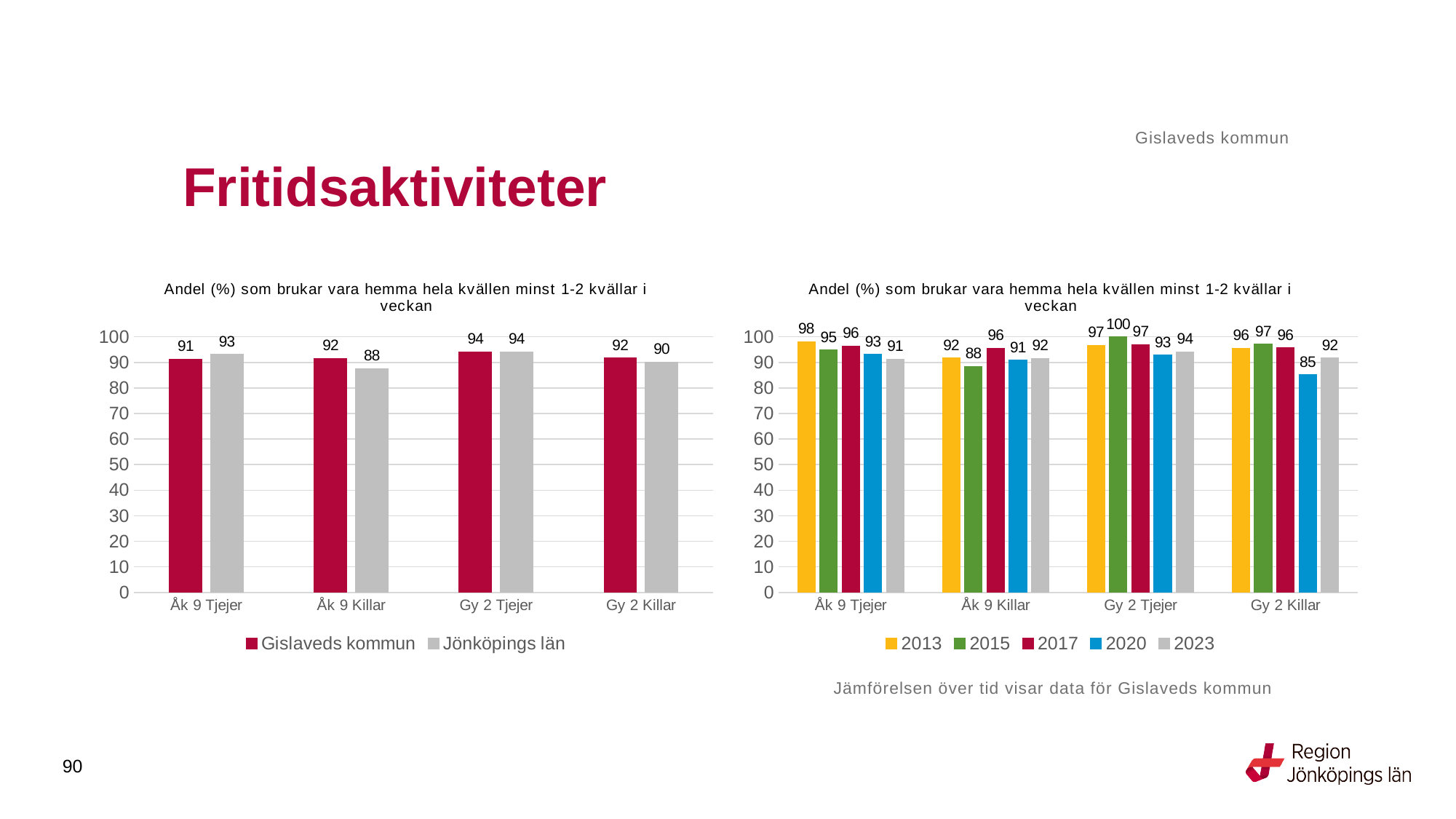
In the left chart, how many series does the legend list? 2 In the right chart, what is the value for 2020 for Gy 2 Killar? 85 In the right chart, which year has the lowest value for Åk 9 Killar? 2015 In the left chart, what is the value for Gislaveds kommun for Gy 2 Tjejer? 94 What kind of chart is the left chart? Bar chart In the left chart, what is the difference between Gislaveds kommun and Jönköpings län for Åk 9 Killar? 4 In the right chart, how many series does the legend list? 5 In the right chart, which year has the highest value for Åk 9 Tjejer? 2013 In the right chart, what is the difference between the 2013 and 2023 values for Åk 9 Tjejer? 7 In the left chart, which is larger for Åk 9 Tjejer: Gislaveds kommun or Jönköpings län? Jönköpings län In the right chart, what is the value for 2015 for Gy 2 Tjejer? 100 In the left chart, what is the value for Jönköpings län for Åk 9 Killar? 88